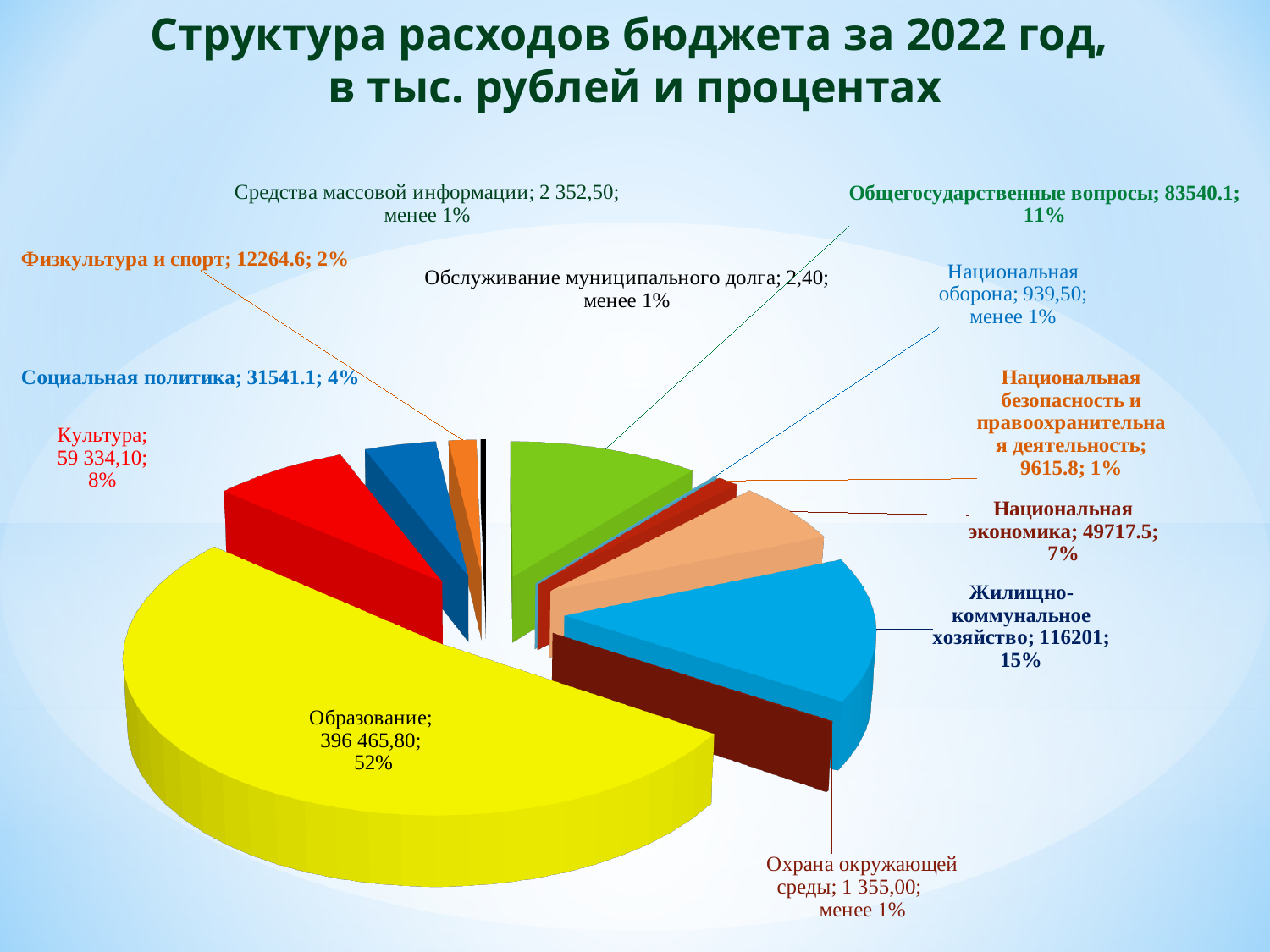
Which is larger: Культура or Национальная экономика? Культура What is the difference between the values for Жилищно-коммунальное хозяйство and Общегосударственные вопросы? 32660.9 What share of the pie does Образование represent? 52% What is the title of the chart? Структура расходов бюджета за 2022 год, в тыс. рублей и процентах What is the value shown for Национальная оборона? 939,50 What is the value shown for Образование? 396 465,80 Which category has the largest share of the pie? Образование What is the value shown for Жилищно-коммунальное хозяйство? 116201 What share of the pie does Общегосударственные вопросы represent? 11% What type of chart is shown on the slide? Pie chart Which category has the smallest value? Обслуживание муниципального долга How many categories (slices) does the pie chart have? 12